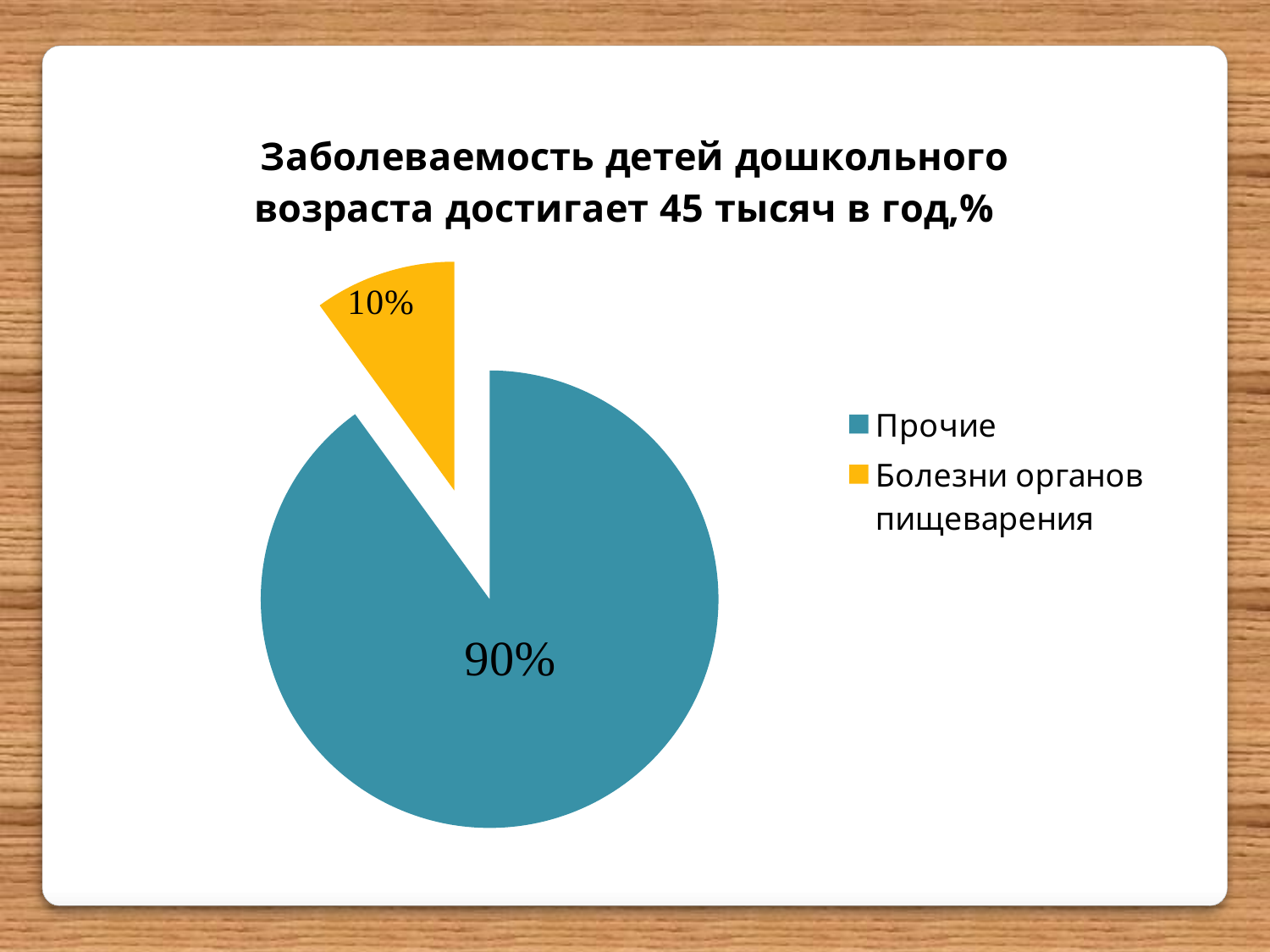
How many slices does the pie chart have? 2 What share of the pie does "Прочие" represent? 90% What kind of chart is shown on the slide? pie chart How many entries does the legend list? 2 What share of the pie does "Болезни органов пищеварения" represent? 10% Which category has the smallest slice of the pie? Болезни органов пищеварения Which category has the largest slice of the pie? Прочие What is the difference in percentage points between the "Прочие" slice and the "Болезни органов пищеварения" slice? 80% What colour is the slice for "Болезни органов пищеварения"? yellow What is the title of the chart? Заболеваемость детей дошкольного возраста достигает 45 тысяч в год,% Which is larger: the slice for "Прочие" or the slice for "Болезни органов пищеварения"? Прочие